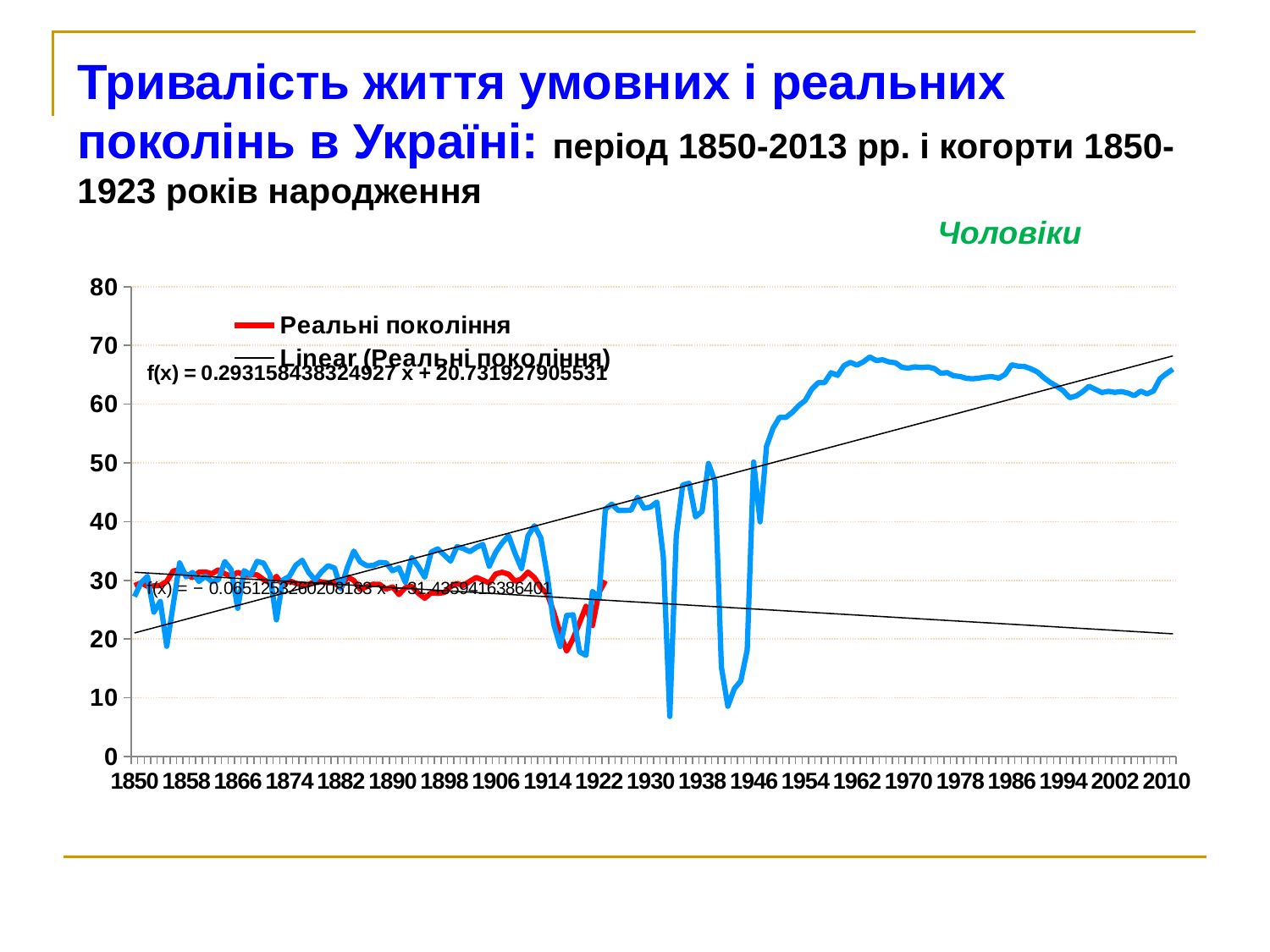
Is the value of the blue line at 1850 greater or less than 40? less Is the value of the blue line at 2010 greater or less than 60? greater Is the value of the red line (Реальні покоління) around 1918 greater or less than 30? less What are the two entries listed in the chart legend? Реальні покоління; Linear (Реальні покоління) Overall, does the blue line rise or fall from 1850 to 2010? rises How many entries does the chart legend list? 2 Does the linear trend line for Реальні покоління (with equation f(x) = -0.0651253260208183 x + 31.4359416386401) rise or fall along the x axis? falls What is the intercept in the trend equation f(x) = 0.293158438324927 x + ... shown on the chart? 20.731927905531 What kind of chart is shown on the slide? line chart